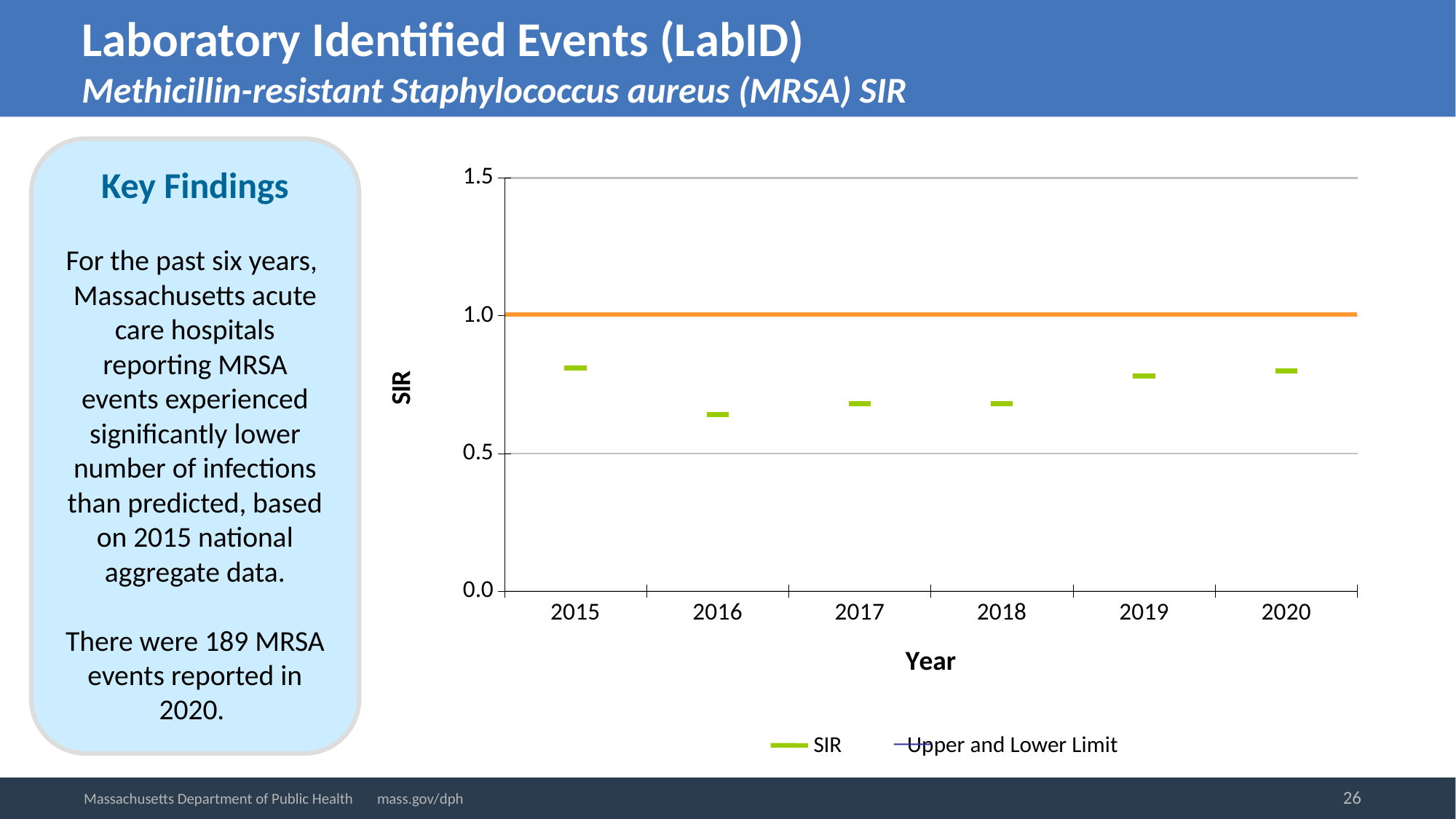
At what value on the y axis is the Upper and Lower Limit line drawn? 1.0 Which year has the lowest SIR value in the chart? 2016 What kind of chart is shown on the slide? line chart Is the SIR value for 2015 greater or less than 0.5? greater What is the title of the x axis of the chart? Year Which is larger, the SIR value for 2015 or for 2016? 2015 Is the SIR value for 2016 greater or less than 1.0? less How many series does the chart legend list? 2 How many years are shown on the x axis of the chart? 6 Is the SIR value for 2020 greater or less than 1.0? less Do the SIR values rise or fall from 2016 to 2020? rise Which is larger, the SIR value for 2019 or for 2017? 2019